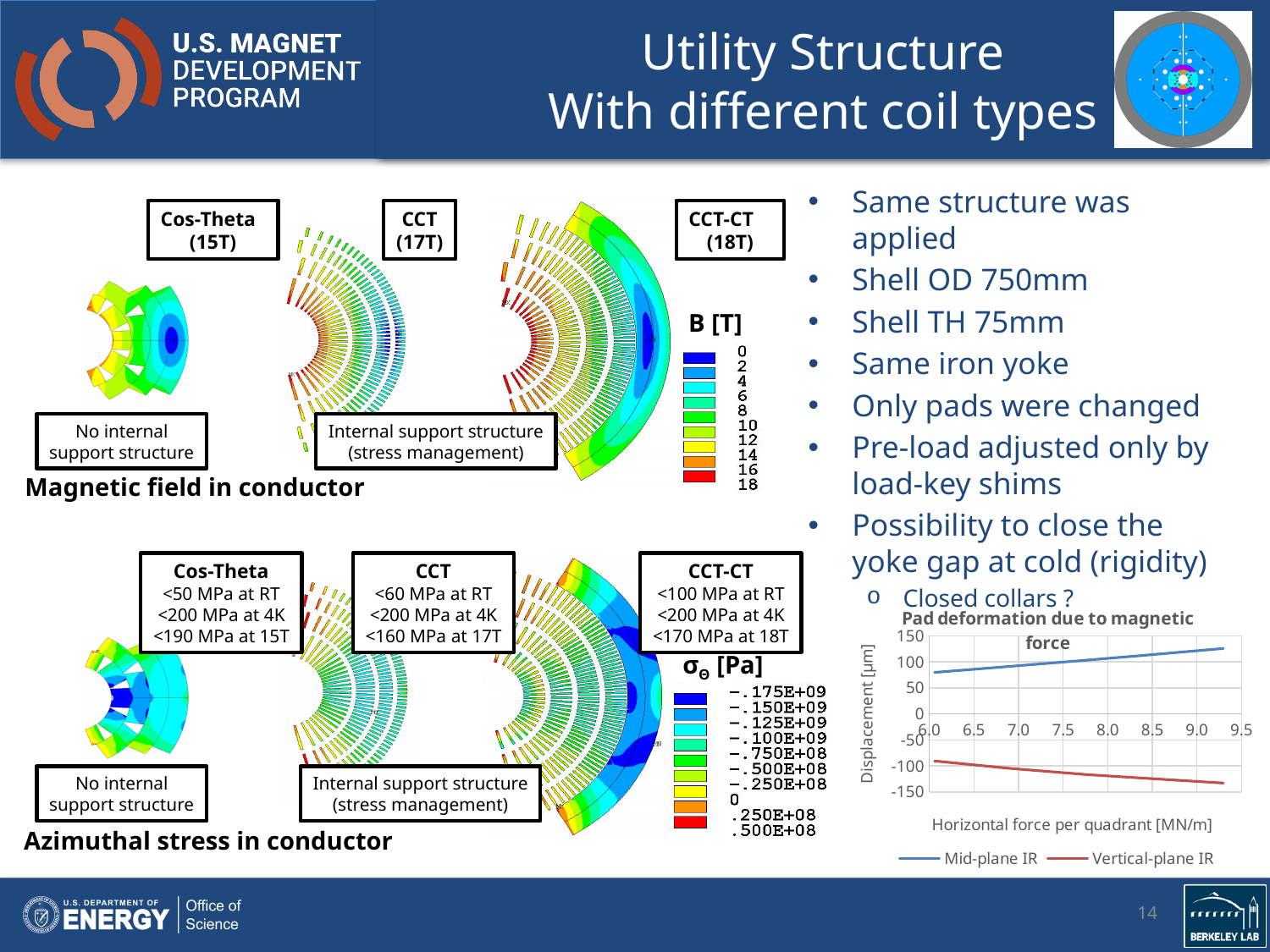
In the "Pad deformation due to magnetic force" chart, is the Mid-plane IR displacement at a horizontal force of 9.0 MN/m greater or less than 100 µm? greater In the "Pad deformation due to magnetic force" chart, does the Mid-plane IR displacement rise or fall as the horizontal force increases? rise In the "Pad deformation due to magnetic force" chart, is the Mid-plane IR displacement at a horizontal force of 6.0 MN/m greater or less than 50 µm? greater How many series does the legend of the "Pad deformation due to magnetic force" chart list? 2 In the "Pad deformation due to magnetic force" chart, is the Mid-plane IR displacement at 9.0 MN/m greater or less than 150 µm? less What is the x-axis label of the "Pad deformation due to magnetic force" chart? Horizontal force per quadrant [MN/m] What kind of chart is the "Pad deformation due to magnetic force" chart? line chart What is the y-axis label of the "Pad deformation due to magnetic force" chart? Displacement [µm] In the "Pad deformation due to magnetic force" chart, does the Vertical-plane IR displacement rise or fall as the horizontal force increases? fall In the "Pad deformation due to magnetic force" chart, which series has the larger displacement values, Mid-plane IR or Vertical-plane IR? Mid-plane IR